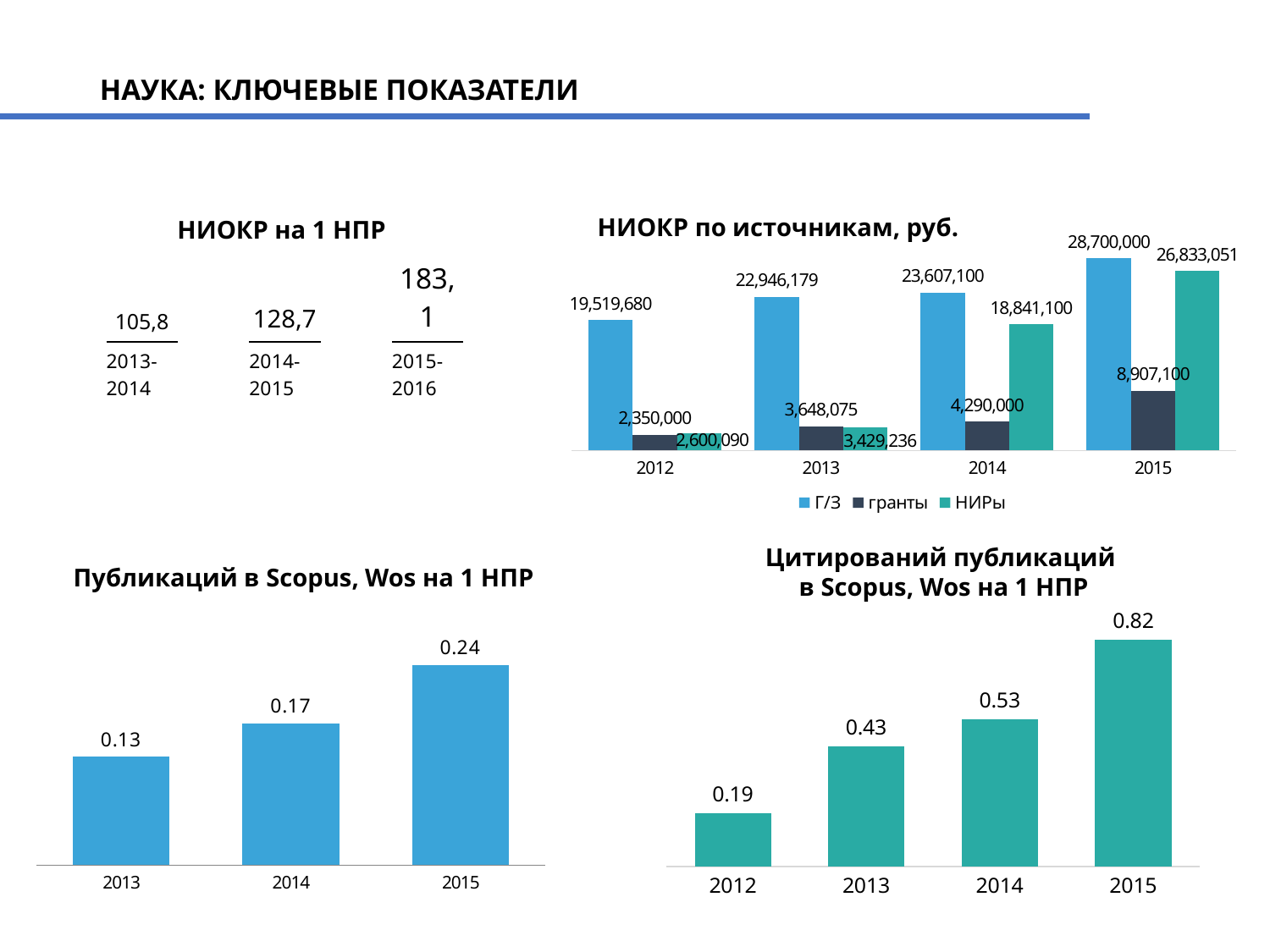
In the chart 'НИОКР по источникам, руб.', what is the value for Г/З in 2015? 28,700,000 In the chart 'НИОКР по источникам, руб.', what is the value for НИРы in 2014? 18,841,100 In the chart 'НИОКР по источникам, руб.', what is the value for гранты in 2013? 3,648,075 In the chart 'НИОКР по источникам, руб.', what is the difference between гранты in 2015 and гранты in 2014? 4,617,100 In the chart 'НИОКР по источникам, руб.', how many series does the legend list? 3 What kind of chart is 'Цитирований публикаций в Scopus, Wos на 1 НПР'? bar chart In the chart 'Цитирований публикаций в Scopus, Wos на 1 НПР', what is the value for 2012? 0.19 In the chart 'НИОКР по источникам, руб.', which is larger in 2015: Г/З or НИРы? Г/З In the chart 'НИОКР по источникам, руб.', which year has the highest value for НИРы? 2015 In the chart 'Публикаций в Scopus, Wos на 1 НПР', what is the value for 2014? 0.17 In the chart 'Цитирований публикаций в Scopus, Wos на 1 НПР', do the values rise or fall from 2012 to 2015? rise In the chart 'Публикаций в Scopus, Wos на 1 НПР', how many years are shown? 3